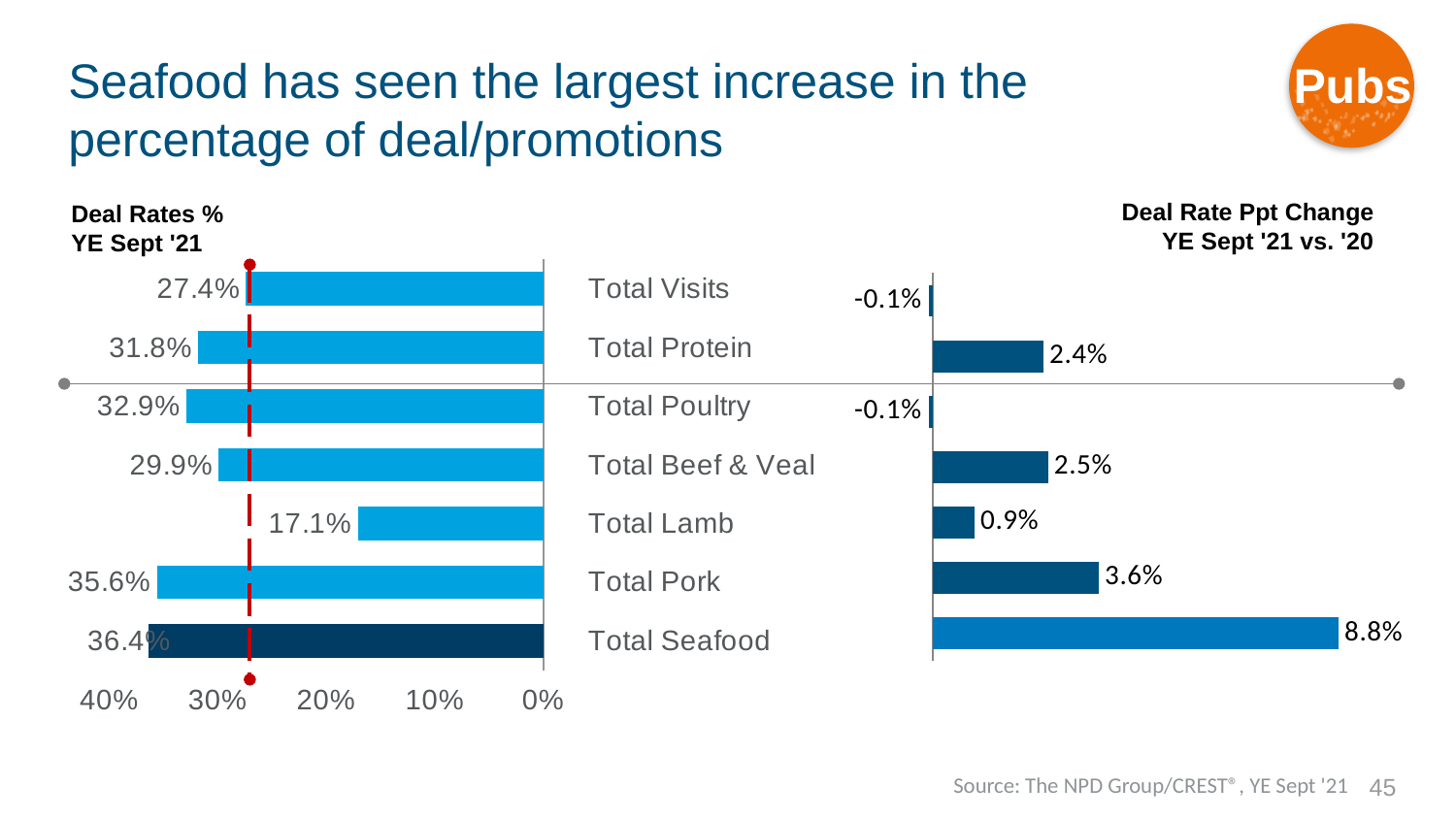
In the Deal Rates % YE Sept '21 chart, which is larger, Total Protein or Total Beef & Veal? Total Protein In the Deal Rates % YE Sept '21 chart, what is the value for Total Lamb? 17.1% How many categories are shown in the Deal Rates % YE Sept '21 chart? 7 In the Deal Rates % YE Sept '21 chart, which category has the lowest deal rate? Total Lamb In the Deal Rate Ppt Change YE Sept '21 vs. '20 chart, what is the difference between Total Seafood and Total Pork? 5.2% In the Deal Rates % YE Sept '21 chart, what is the difference between Total Seafood and Total Visits? 9.0% In the Deal Rates % YE Sept '21 chart, is the value for Total Pork greater or less than 30%? greater In the Deal Rates % YE Sept '21 chart, what is the value for Total Seafood? 36.4% In the Deal Rate Ppt Change YE Sept '21 vs. '20 chart, what is the value for Total Poultry? -0.1% In the Deal Rate Ppt Change YE Sept '21 vs. '20 chart, what is the value for Total Pork? 3.6% What type of chart is the Deal Rate Ppt Change YE Sept '21 vs. '20 chart? Bar chart In the Deal Rate Ppt Change YE Sept '21 vs. '20 chart, which category has the highest change? Total Seafood